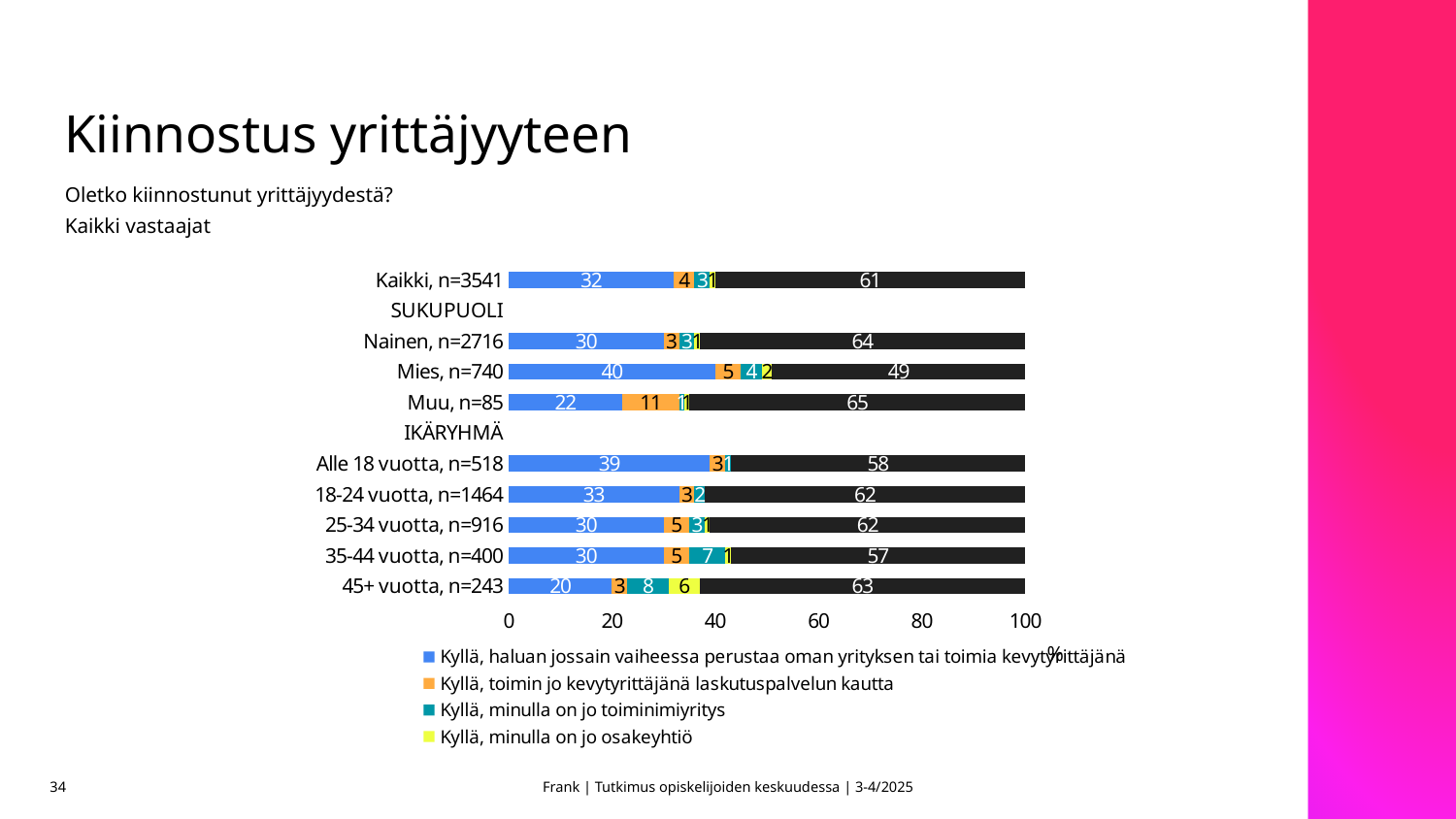
What is the value of the 'Kyllä, toimin jo kevytyrittäjänä laskutuspalvelun kautta' series for 'Muu, n=85'? 11 What is the title of the slide containing the chart? Kiinnostus yrittäjyyteen Which has the larger black segment value, 'Muu, n=85' or 'Mies, n=740'? Muu, n=85 Which category has the highest value for the 'Kyllä, haluan jossain vaiheessa perustaa oman yrityksen tai toimia kevytyrittäjänä' series? Mies, n=740 What is the value of the 'Kyllä, haluan jossain vaiheessa perustaa oman yrityksen tai toimia kevytyrittäjänä' series for 'Mies, n=740'? 40 Which category has the lowest value for the 'Kyllä, haluan jossain vaiheessa perustaa oman yrityksen tai toimia kevytyrittäjänä' series? 45+ vuotta, n=243 What is the value of the black segment for '45+ vuotta, n=243'? 63 What is the difference between the 'Kyllä, haluan jossain vaiheessa perustaa oman yrityksen tai toimia kevytyrittäjänä' values for 'Mies, n=740' and 'Nainen, n=2716'? 10 What kind of chart is shown on the slide? bar chart What is the value of the black segment for 'Nainen, n=2716'? 64 How many series does the legend list? 4 Is the black segment value for 'Mies, n=740' greater or less than 40? greater